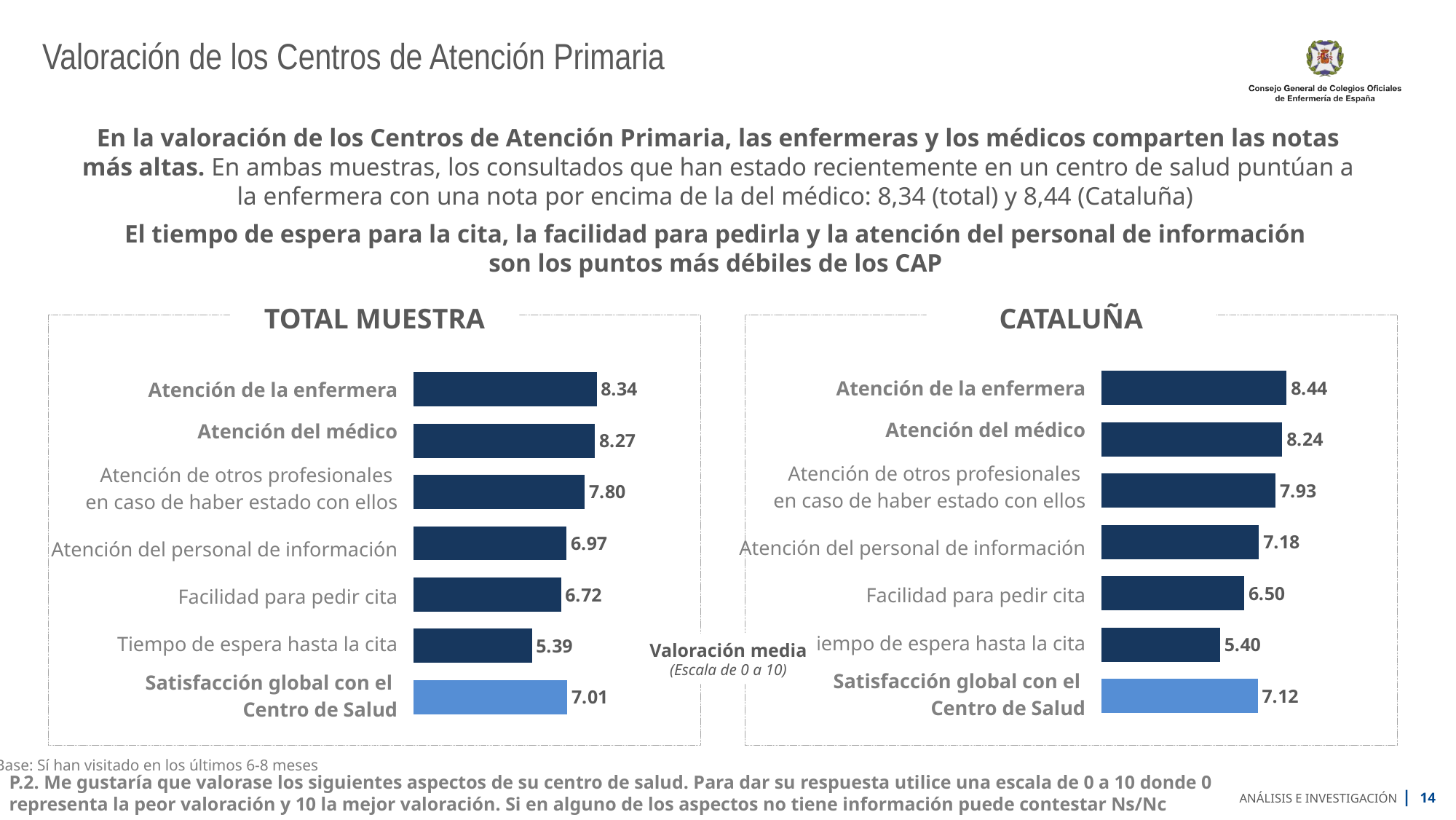
How many categories are plotted in the TOTAL MUESTRA chart? 7 In the TOTAL MUESTRA chart, which bar is shown in a lighter blue colour than the others? Satisfacción global con el Centro de Salud In the CATALUÑA chart, what is the value for Satisfacción global con el Centro de Salud? 7.12 Which chart shows a higher value for Tiempo de espera hasta la cita, TOTAL MUESTRA or CATALUÑA? CATALUÑA What type of chart is the CATALUÑA chart? Bar chart In the CATALUÑA chart, what is the difference between Atención del personal de información and Facilidad para pedir cita? 0.68 In the TOTAL MUESTRA chart, which is larger: Atención del personal de información or Facilidad para pedir cita? Atención del personal de información In the CATALUÑA chart, which category has the highest value? Atención de la enfermera In the TOTAL MUESTRA chart, which category has the lowest value? Tiempo de espera hasta la cita In the TOTAL MUESTRA chart, what is the value for Atención de la enfermera? 8.34 In the TOTAL MUESTRA chart, what is the difference between Atención de la enfermera and Atención del médico? 0.07 In the CATALUÑA chart, what is the value for Facilidad para pedir cita? 6.50